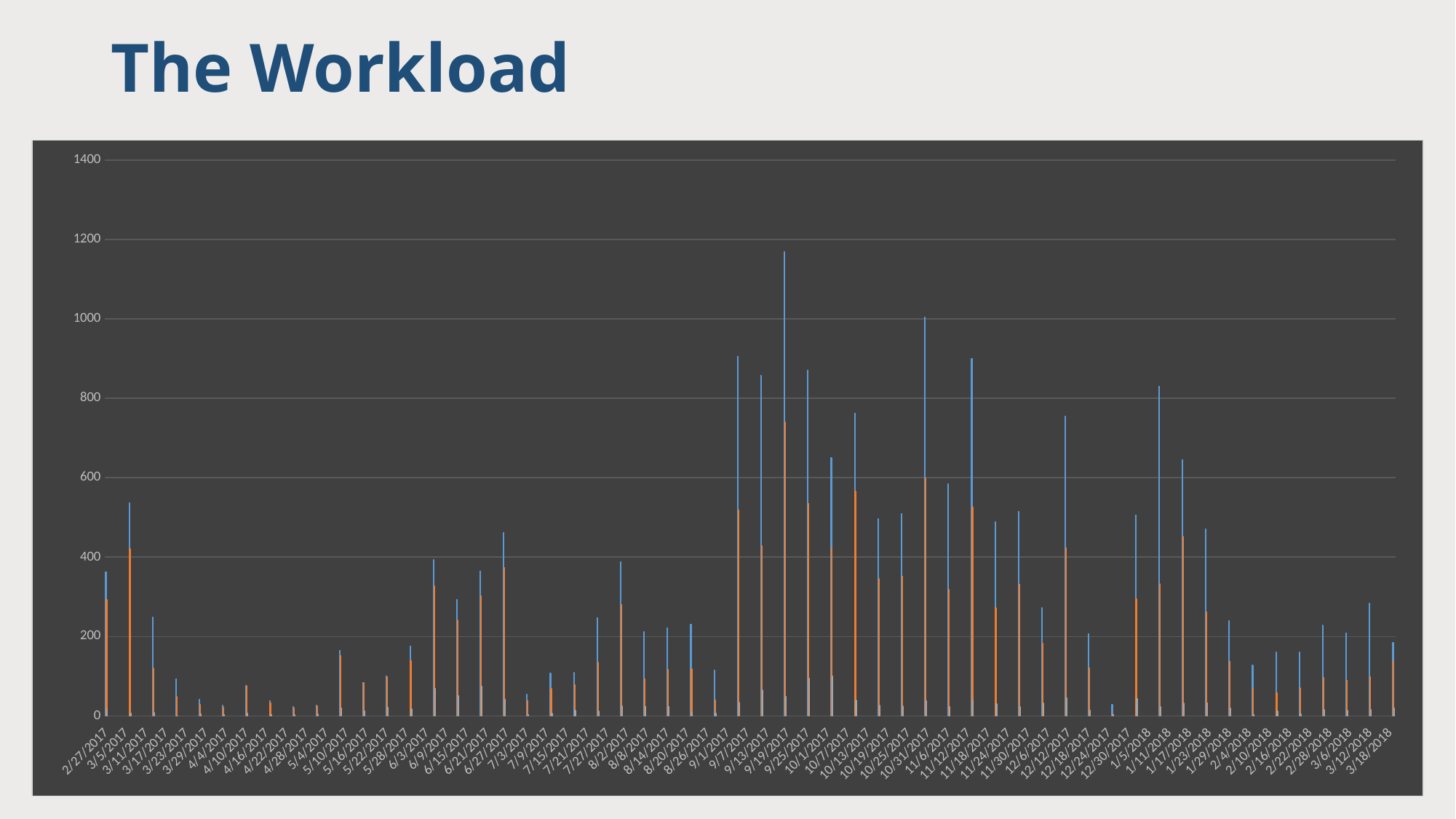
Is the blue bar for 3/5/2017 greater or less than 400? greater What is the highest value shown on the vertical axis? 1400 Is the blue bar for 4/4/2017 greater or less than 200? less Is the blue bar for 9/7/2017 greater or less than 800? greater Which has the taller blue bar, 9/19/2017 or 10/31/2017? 9/19/2017 Which date has the tallest blue bar? 9/19/2017 What kind of chart is shown on the slide? bar chart Which has the taller blue bar, 9/7/2017 or 3/5/2017? 9/7/2017